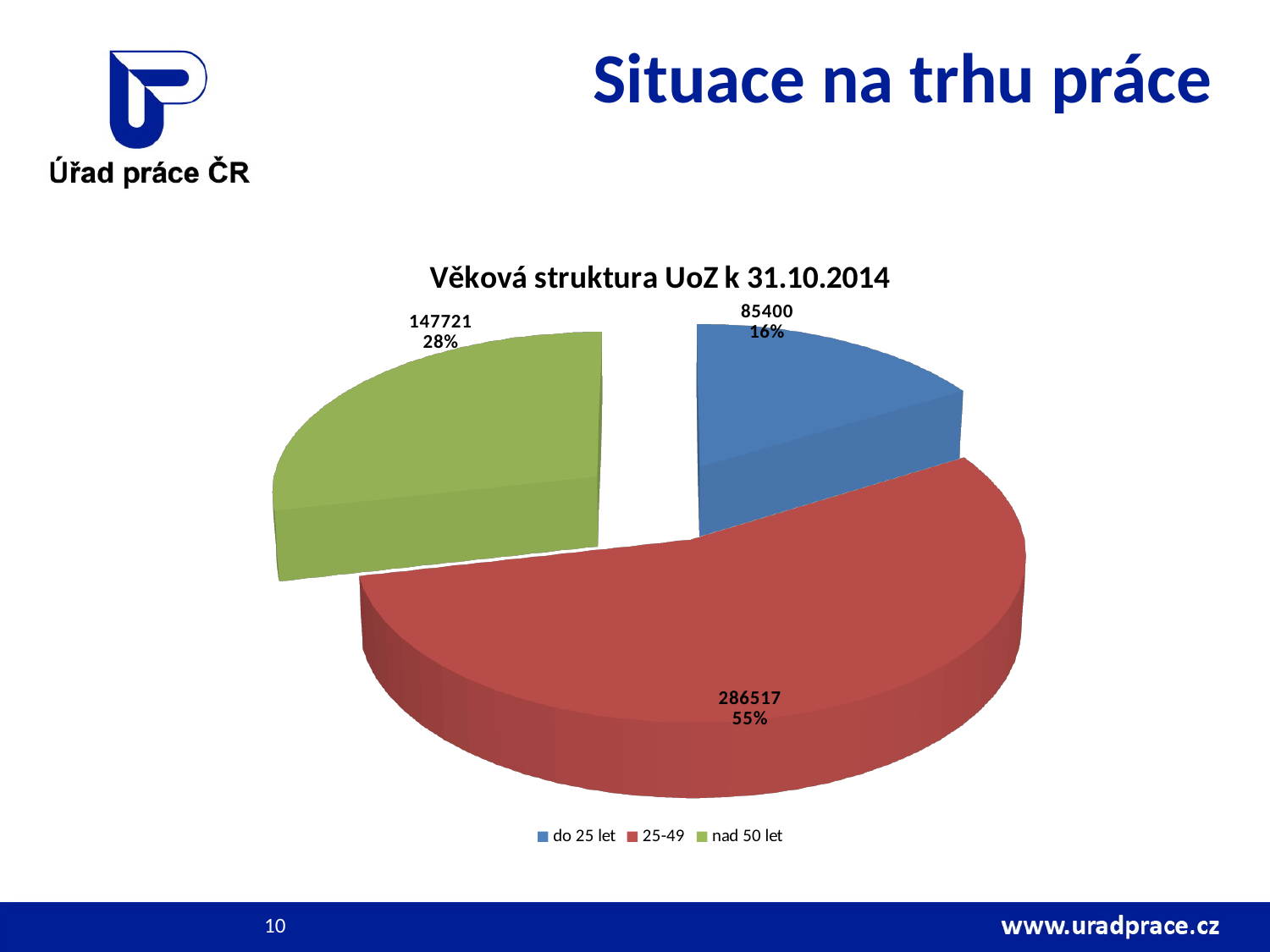
What is the value for the 'do 25 let' slice? 85400 Which is larger, the value for 'nad 50 let' or the value for 'do 25 let'? nad 50 let What is the title of the chart? Věková struktura UoZ k 31.10.2014 What kind of chart is shown on the slide? Pie chart How many slices does the pie chart have? 3 What share of the pie does the 'do 25 let' slice represent? 16% Which age group has the smallest slice? do 25 let What is the value for the '25-49' slice? 286517 What share of the pie does the 'nad 50 let' slice represent? 28% What is the difference between the values for '25-49' and 'nad 50 let'? 138796 What is the value for the 'nad 50 let' slice? 147721 Which age group has the largest slice? 25-49